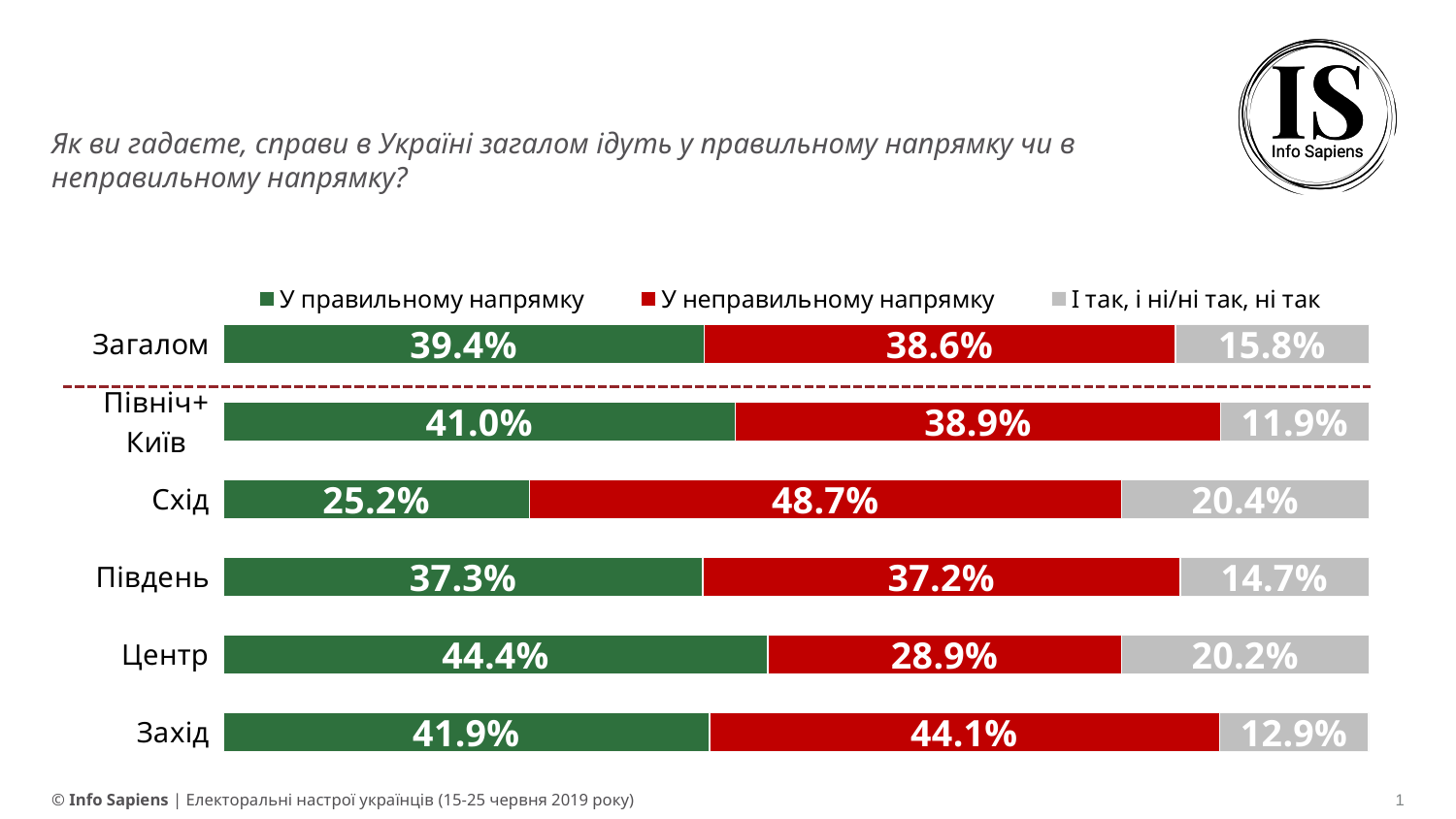
What percentage of respondents in Схід said things are going in the wrong direction (У неправильному напрямку)? 48.7% What type of chart is shown on the slide? Stacked bar chart What is the difference between У правильному напрямку and У неправильному напрямку for Центр? 15.5 percentage points What is the value for У правильному напрямку in the Загалом bar? 39.4% What share of respondents in Центр answered І так, і ні/ні так, ні так? 20.2% What is the total of the three segments in the Схід bar? 94.3% How many series does the legend list? 3 How many bars (categories) are shown in the chart? 6 In Захід, which is larger: У правильному напрямку or У неправильному напрямку? У неправильному напрямку Which region has the highest value for У неправильному напрямку? Схід Which region has the highest value for У правильному напрямку? Центр Which region has the lowest value for У правильному напрямку? Схід